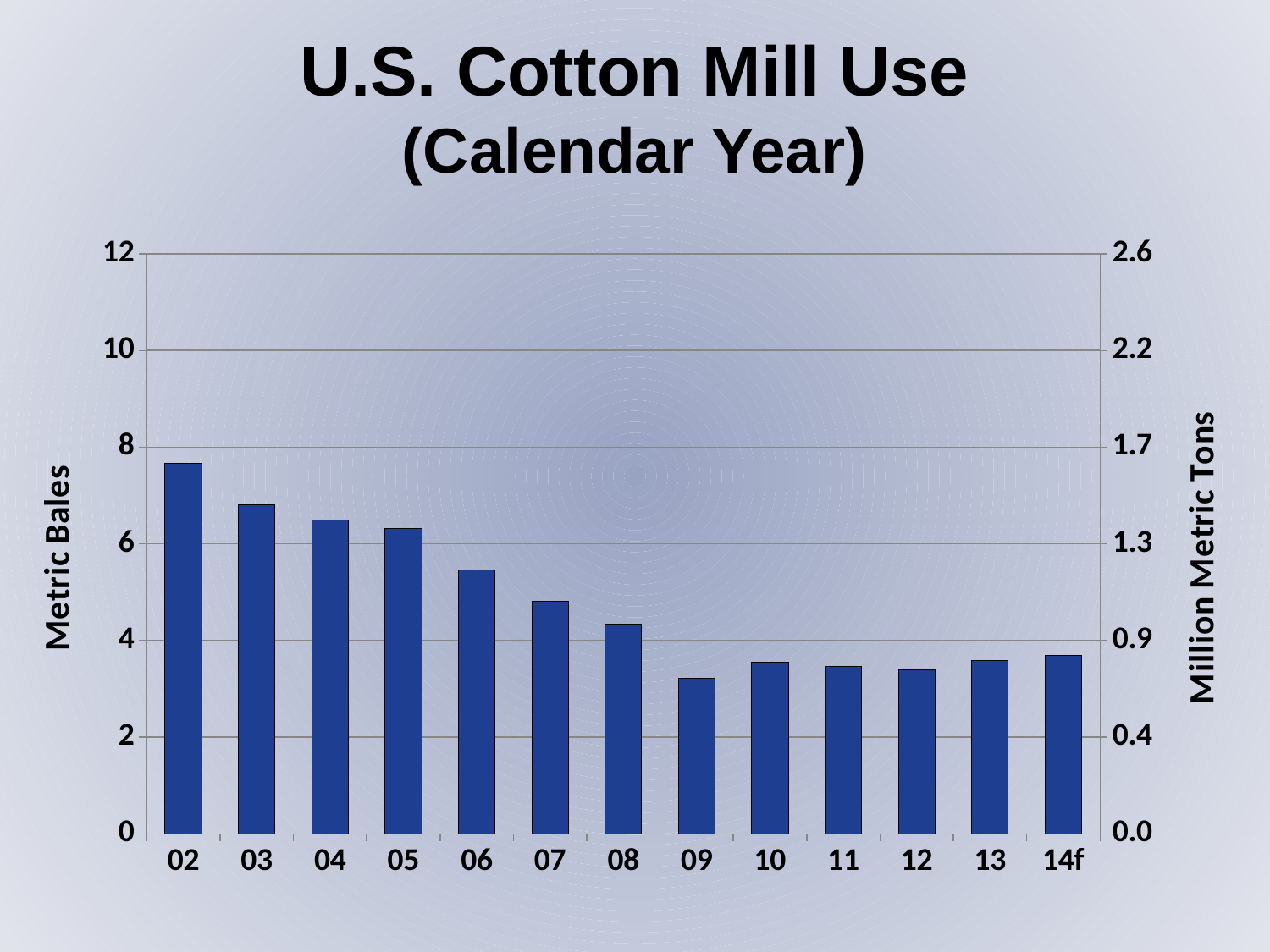
Is the value for 07 greater or less than 6 on the Metric Bales axis? less Is the value for 09 greater or less than 4 on the Metric Bales axis? less Do the values generally rise or fall from 02 to 14f? fall What is the label on the right-hand vertical axis? Million Metric Tons Which year has the lowest U.S. cotton mill use? 09 Is the value for 06 greater or less than 4 on the Metric Bales axis? greater Which is larger, the value for 03 or the value for 08? 03 What kind of chart is shown on the slide? bar chart Which year has the highest U.S. cotton mill use? 02 Which is larger, the value for 10 or the value for 06? 06 How many years (bars) are plotted on the chart? 13